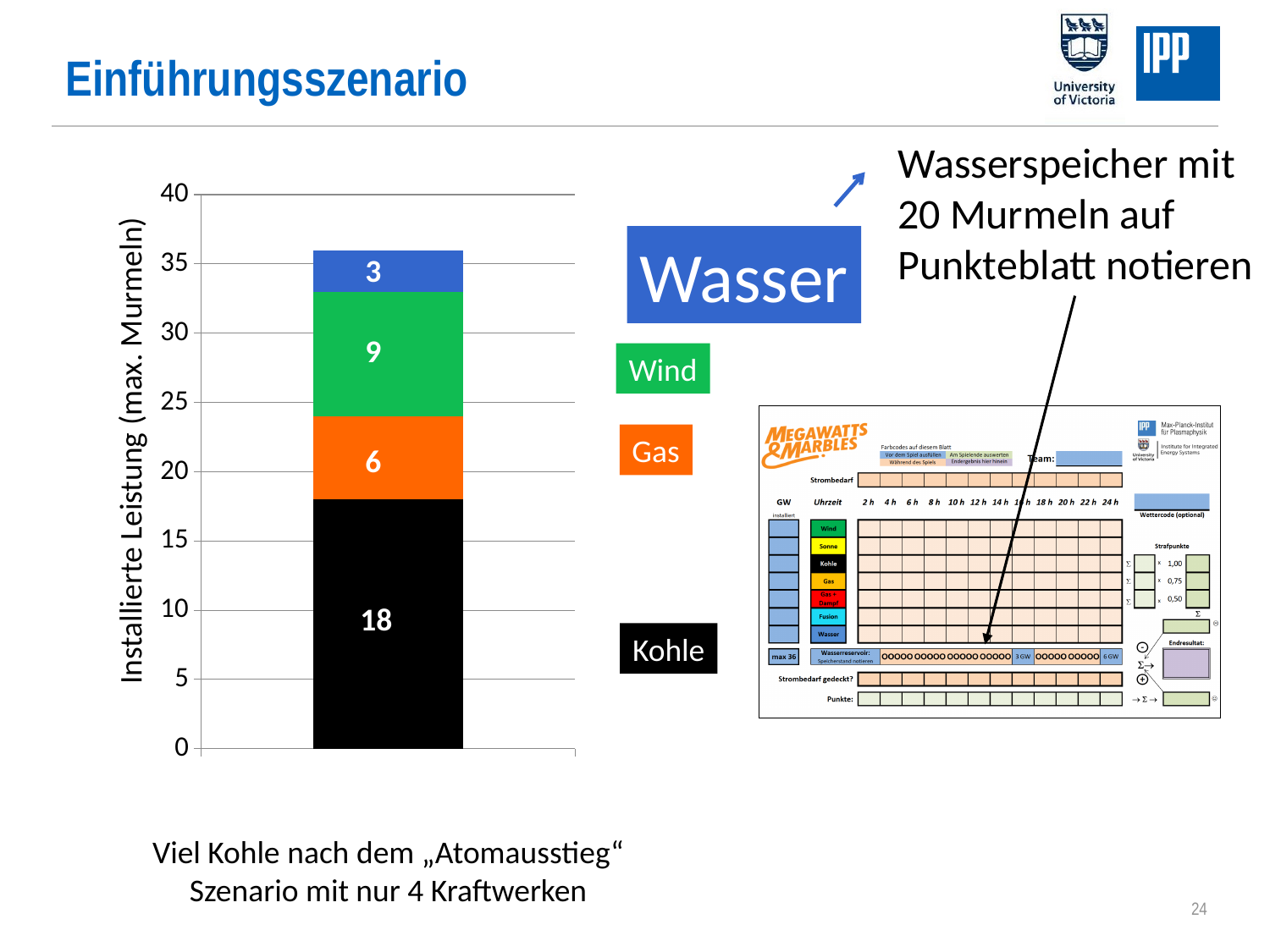
What is the value of the Wind (green) segment of the bar? 9 How many segments make up the stacked bar? 4 What is the difference between the Kohle and Wind segment values? 9 What is the label of the y-axis? Installierte Leistung (max. Murmeln) What is the value of the Wasser (blue) segment of the bar? 3 Which segment of the stacked bar has the largest value? Kohle What type of chart is shown on the slide? stacked bar chart What is the value of the Gas (orange) segment of the bar? 6 What is the value of the Kohle (black) segment of the bar? 18 Which segment of the stacked bar has the smallest value? Wasser What is the total of the stacked bar? 36 Which is larger, the Wind segment or the Gas segment? Wind